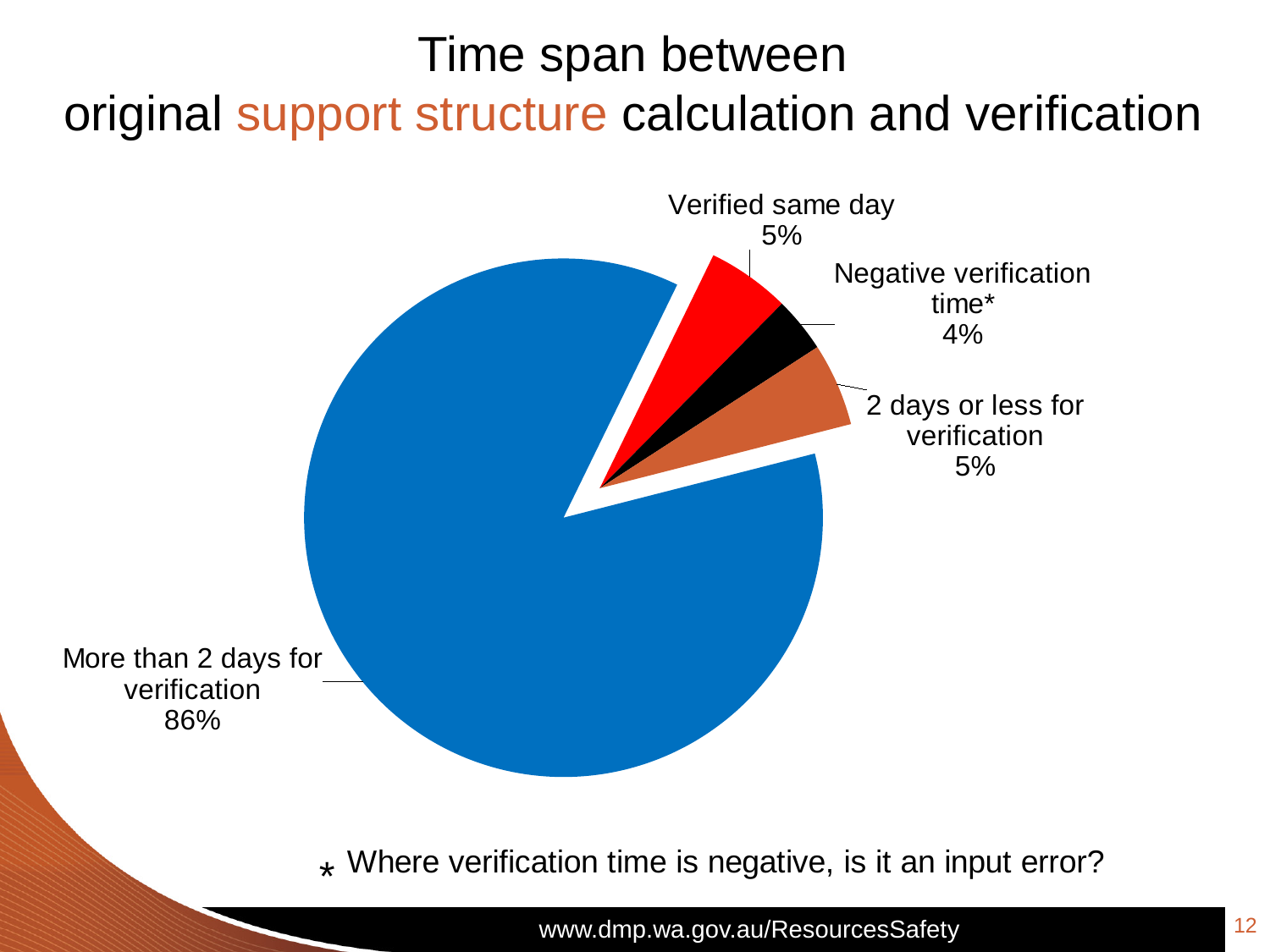
What share of the pie is '2 days or less for verification'? 5% How many slices does the pie chart have? 4 What is the difference in percentage points between '2 days or less for verification' and 'Negative verification time*'? 1 What colour is the 'More than 2 days for verification' slice? Blue What share of the pie is 'Negative verification time*'? 4% What is the difference in percentage points between 'More than 2 days for verification' and 'Verified same day'? 81 Which is larger: 'Verified same day' or 'Negative verification time*'? Verified same day Which category has the largest slice of the pie? More than 2 days for verification What share of the pie is 'More than 2 days for verification'? 86% Which category has the smallest slice of the pie? Negative verification time* What kind of chart is shown on the slide? Pie chart